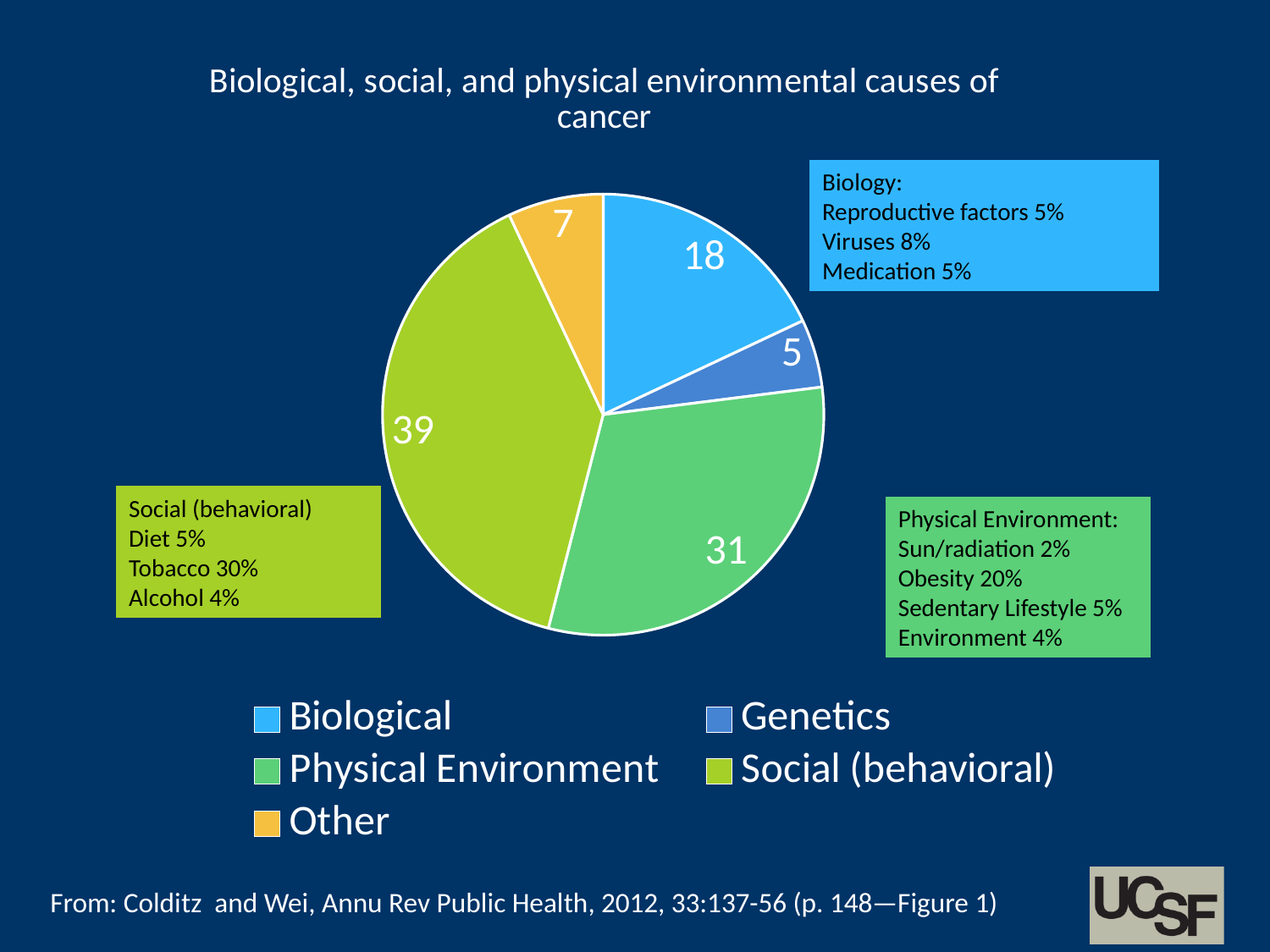
What is the value for the Physical Environment slice? 31 What is the value for the Genetics slice? 5 What is the value for the Other slice? 7 What is the value for the Social (behavioral) slice? 39 What is the difference between the Social (behavioral) and Physical Environment values? 8 What is the value for the Biological slice? 18 Which category has the largest slice of the pie? Social (behavioral) Which is larger, the Biological slice or the Other slice? Biological What type of chart is shown on the slide? pie chart What is the title of the chart? Biological, social, and physical environmental causes of cancer Which category has the smallest slice of the pie? Genetics How many categories does the legend list? 5